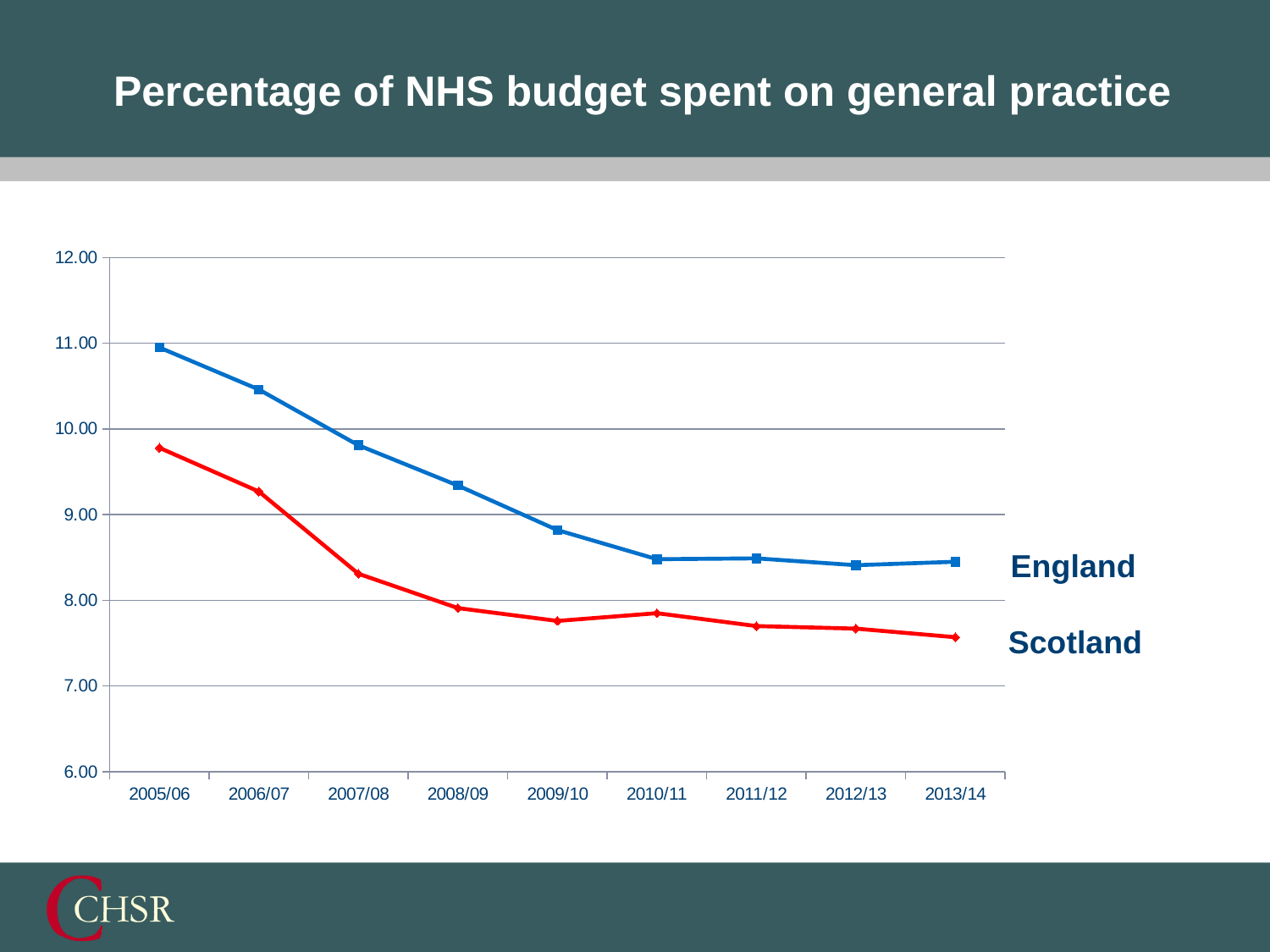
How many series are plotted on the chart? 2 What kind of chart is shown on the slide? Line chart Is the Scotland value for 2013/14 greater or less than 8.00? less In which year is the England value highest? 2005/06 Which is larger in 2008/09, the England value or the Scotland value? England Is the England value for 2013/14 greater or less than 8.00? greater Do the Scotland values generally rise or fall from 2005/06 to 2013/14? Fall Is the England value for 2006/07 greater or less than 10.00? greater What is the title of the chart? Percentage of NHS budget spent on general practice In which year is the Scotland value lowest? 2013/14 How many financial years are shown along the x axis? 9 Which series is plotted in red? Scotland